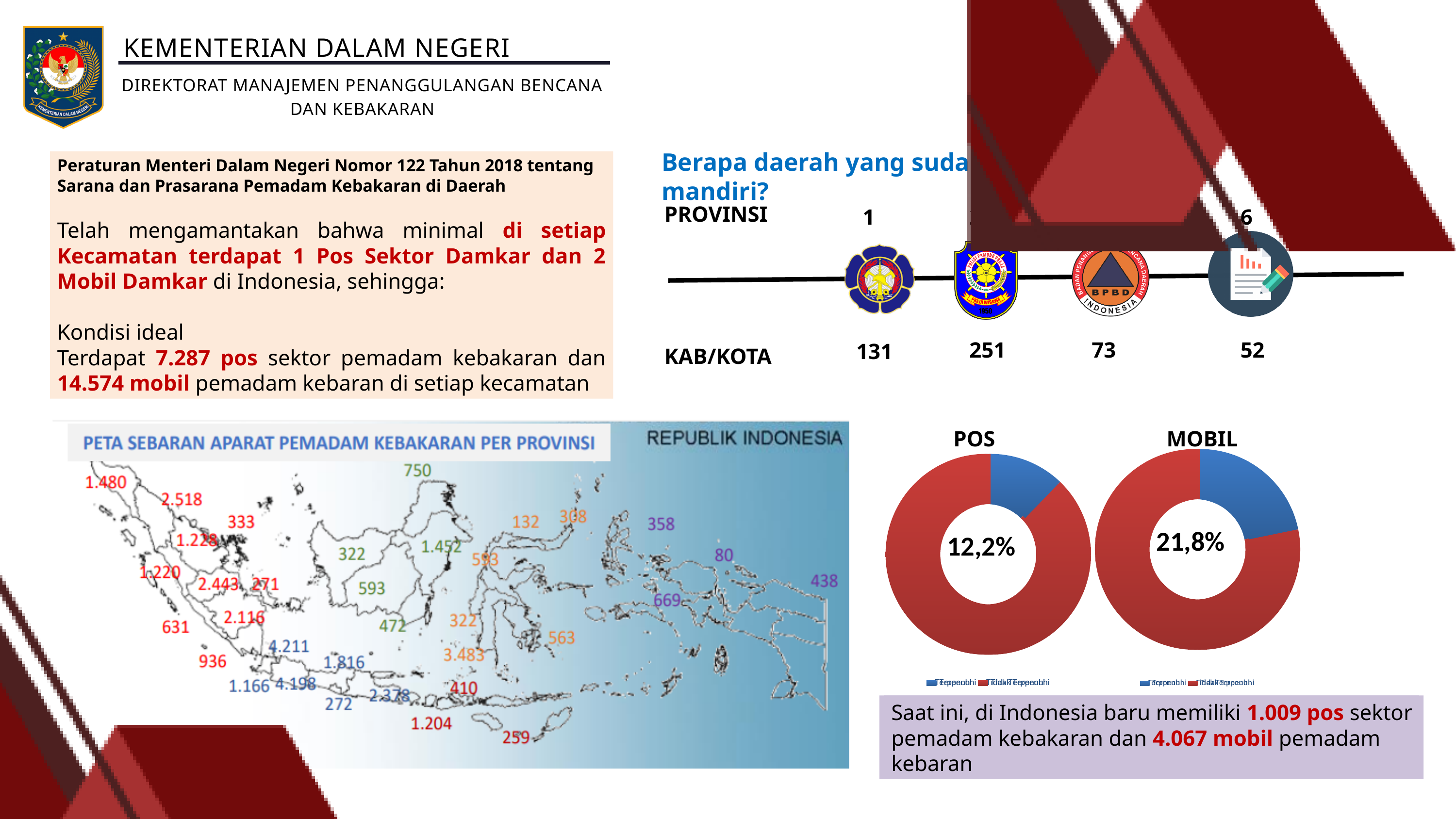
In the POS chart, which colour slice is larger, blue or red? Red What is the difference between the centre percentage of the MOBIL chart and that of the POS chart? 9,6% In the POS chart, what percentage is printed in the centre of the donut? 12,2% What are the titles of the two donut charts on the slide? POS and MOBIL How many slices does the MOBIL donut chart have? 2 Which chart shows the larger centre percentage, POS or MOBIL? MOBIL How many donut charts are shown on the slide? 2 How many slices does the POS donut chart have? 2 Which two colours are used for the slices in the POS and MOBIL charts? Blue and red What kind of chart is used for the POS and MOBIL charts on the right of the slide? Pie (donut) chart In the MOBIL chart, what percentage is printed in the centre of the donut? 21,8% In the MOBIL chart, which colour slice is smaller, blue or red? Blue